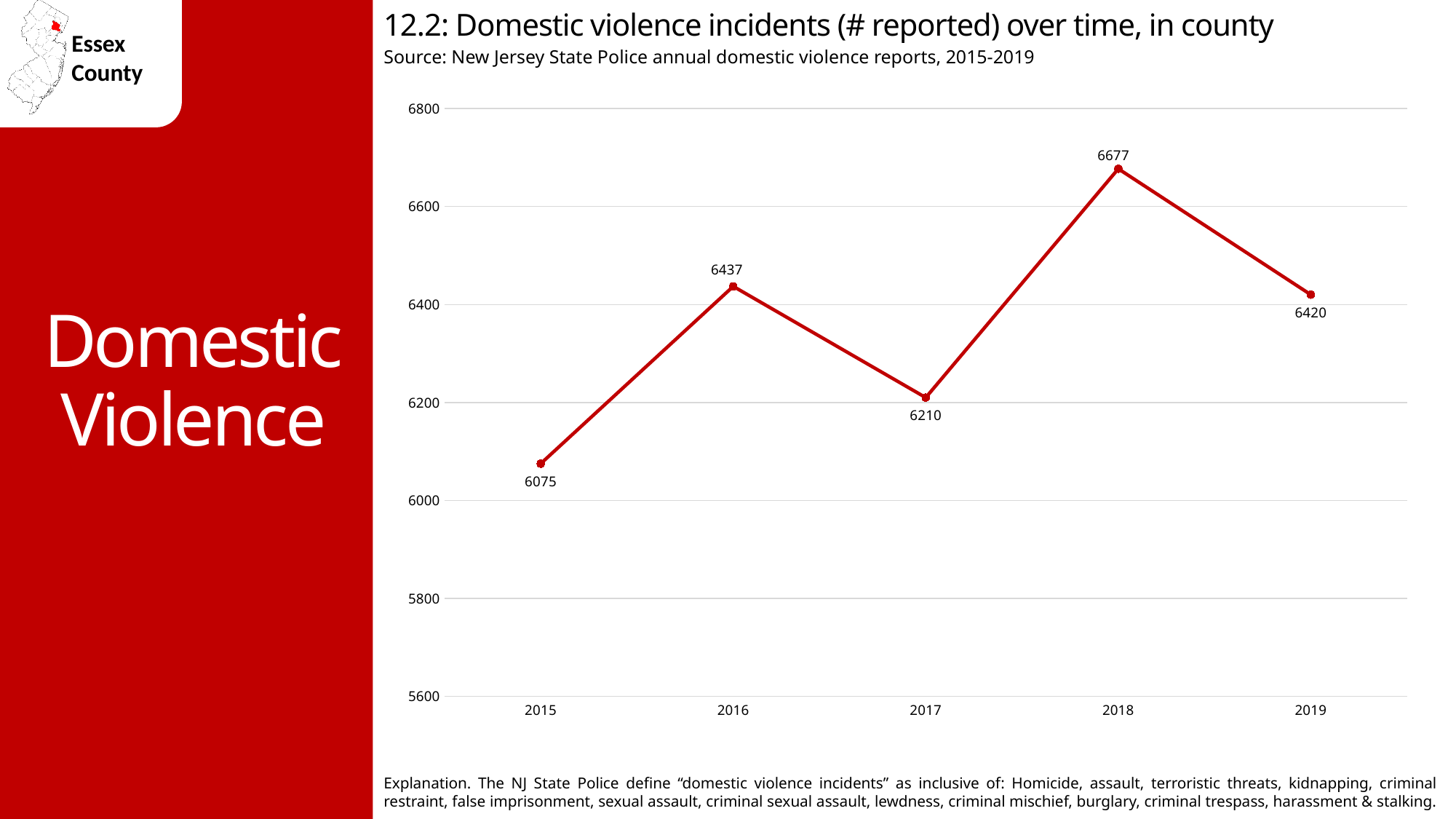
What is the difference between the 2018 and 2017 values? 467 Which year had more reported incidents, 2016 or 2019? 2016 Which year has the lowest number of reported domestic violence incidents? 2015 Did the number of reported incidents rise or fall from 2018 to 2019? fall Is the value for 2017 greater or less than 6400? less What is the value plotted for 2018? 6677 What kind of chart is shown on the slide? line chart How many years are plotted on the chart? 5 How many incidents were reported in 2017? 6210 How many domestic violence incidents were reported in 2015? 6075 By how much did reported incidents change from 2015 to 2016? 362 Which year has the highest number of reported domestic violence incidents? 2018